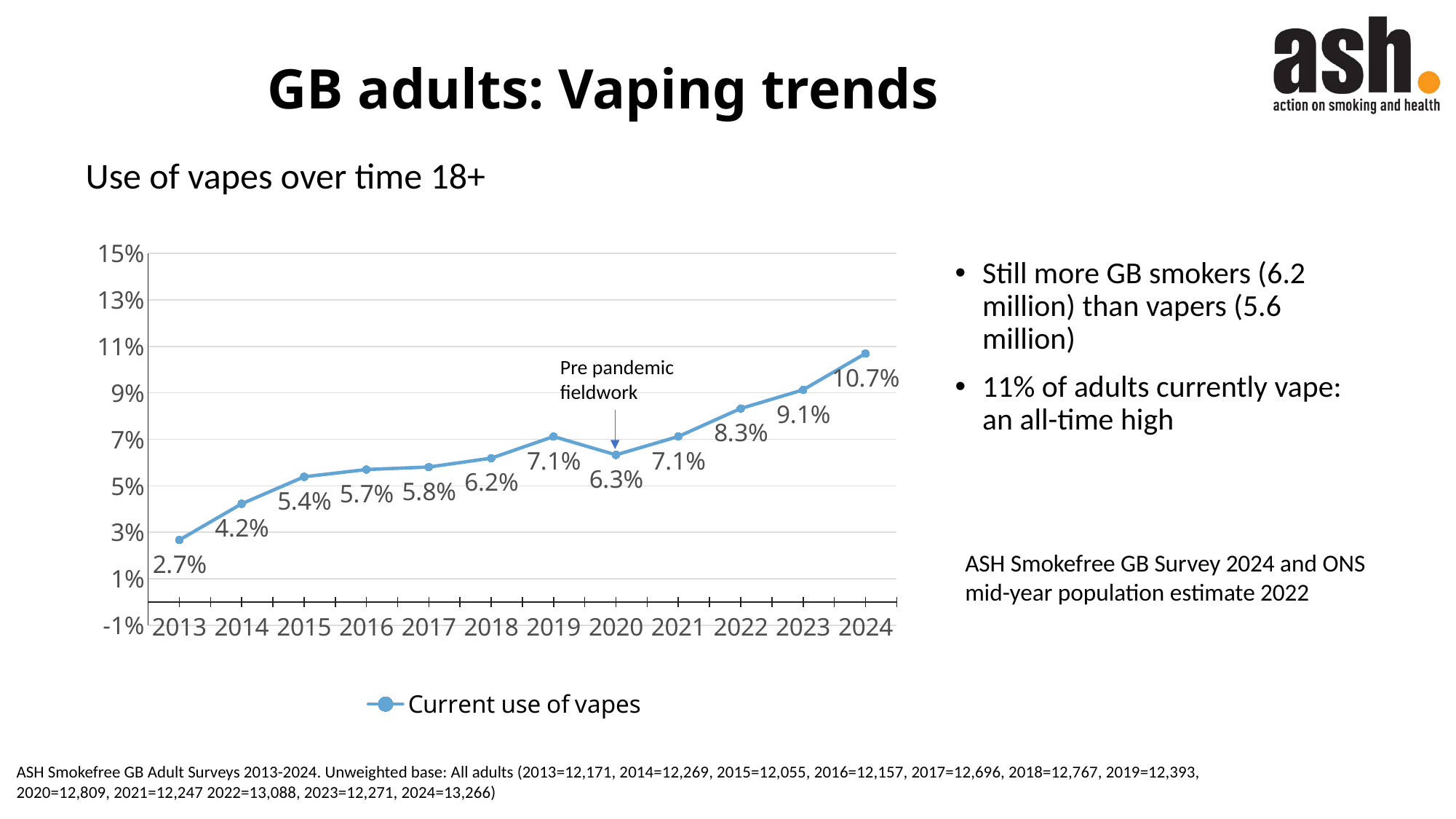
What is the title of the chart? Use of vapes over time 18+ What is the value for current use of vapes in 2020? 6.3% What is the value for current use of vapes in 2024? 10.7% How many series does the legend list? 1 What is the difference between the 2024 and 2023 values for current use of vapes? 1.6% What kind of chart is shown on the slide? line chart Which year has the lowest value for current use of vapes? 2013 Is the value for 2022 greater or less than 9%? less Which is larger, the value for 2019 or the value for 2020? 2019 Which year has the highest value for current use of vapes? 2024 What is the value for current use of vapes in 2013? 2.7% How many years are plotted on the x axis? 12